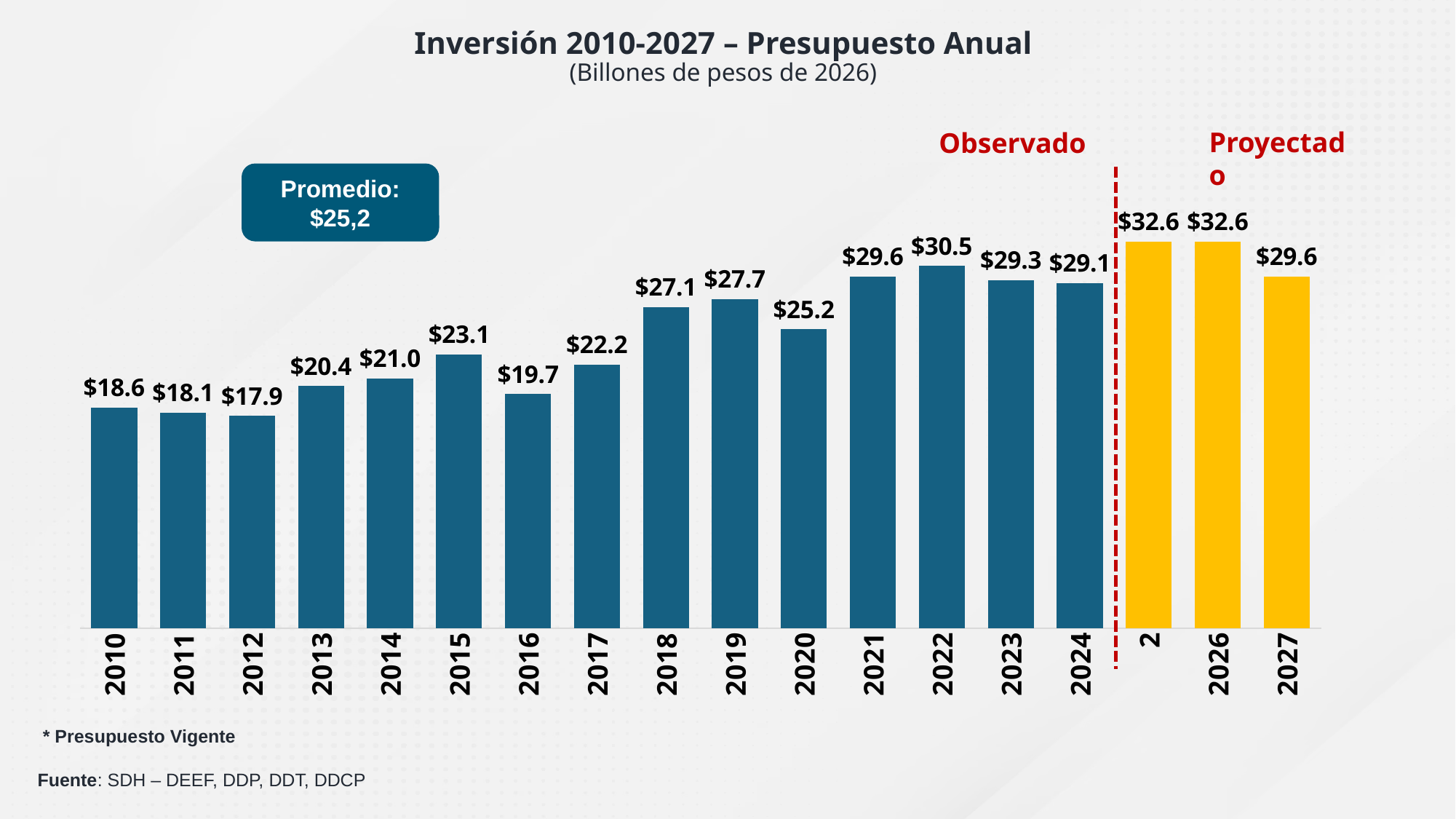
Which is larger, the value for 2020 or the value for 2019? 2019 What is the difference between the values for 2018 and 2017? $4.9 What kind of chart is shown on the slide? Bar chart What average (Promedio) value is shown in the box on the slide? $25,2 What is the highest value shown on the chart? $32.6 What is the difference between the values for 2026 and 2027? $3.0 How many bars are shown on the chart? 18 What is the value for 2016? $19.7 What is the value for 2010? $18.6 Which year has the lowest value? 2012 What is the value for 2027? $29.6 What is the value for 2022? $30.5